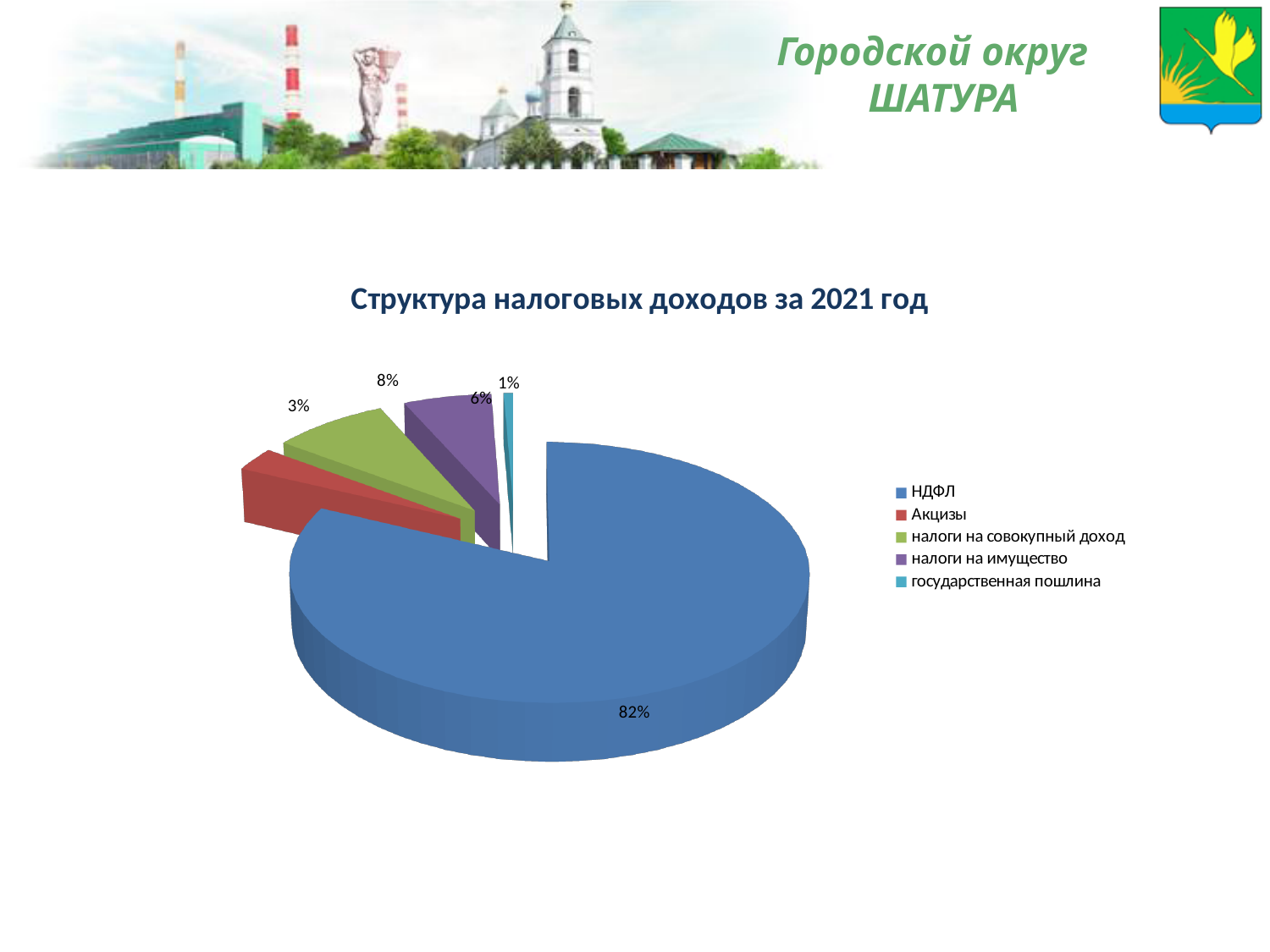
How many categories does the pie chart show? 5 What share of tax revenues does налоги на совокупный доход account for? 8% What share of tax revenues does государственная пошлина account for? 1% What share of tax revenues does налоги на имущество account for? 6% Which category has the largest share of tax revenues? НДФЛ Which category has the smallest share of tax revenues? государственная пошлина What is the title of the chart? Структура налоговых доходов за 2021 год What is the difference in percentage points between the share of НДФЛ and the share of налоги на совокупный доход? 74 Which has a larger share: налоги на имущество or Акцизы? налоги на имущество What kind of chart is shown on the slide? pie chart